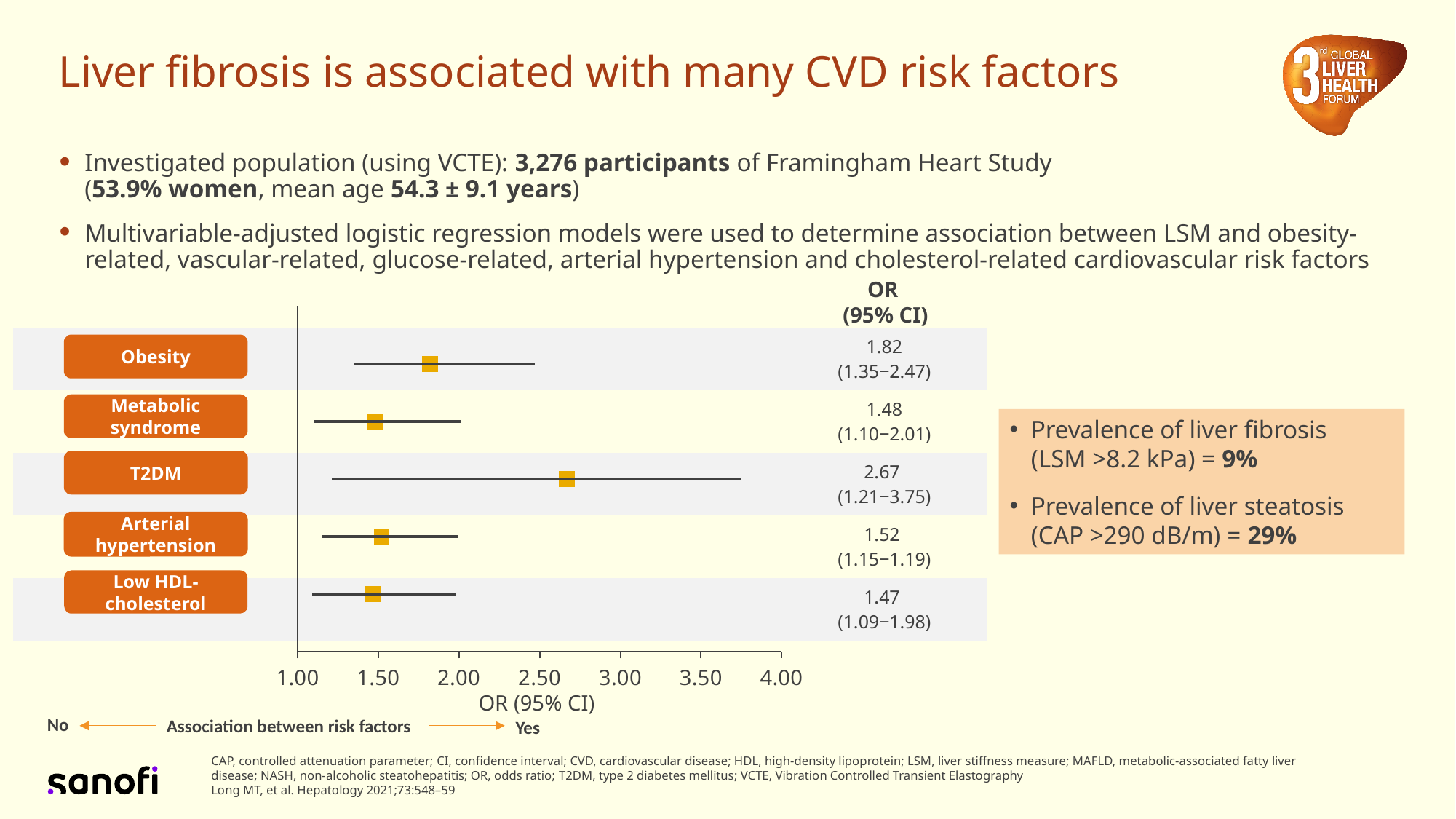
Which risk factor has the lowest OR? Low HDL-cholesterol What is the difference between the OR for T2DM and the OR for Obesity? 0.85 What kind of chart is shown on the slide? Forest plot (point estimates with confidence interval bars) Which has a larger OR, Obesity or Arterial hypertension? Obesity Is the OR for T2DM greater or less than 2.00? greater Which risk factor has the highest OR? T2DM What is the odds ratio (OR) shown for Obesity? 1.82 How many risk factors are plotted in the chart? 5 What is the OR shown for Low HDL-cholesterol? 1.47 What is the 95% CI printed for T2DM? (1.21–3.75) What is the OR shown for Arterial hypertension? 1.52 What is the label of the x axis of the chart? OR (95% CI)